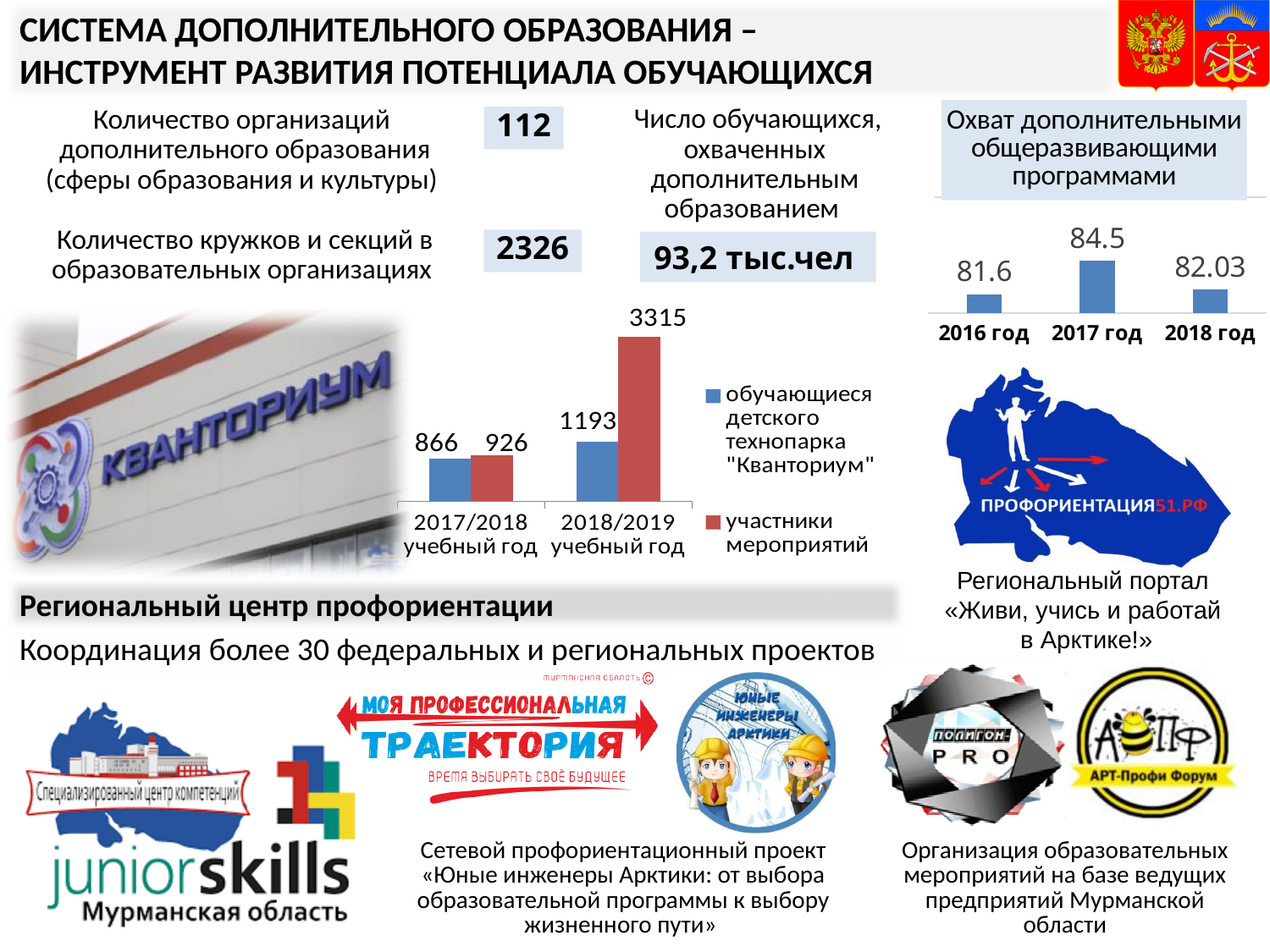
In the Кванториум bar chart in the middle of the slide, which is larger in 2017/2018 учебный год: обучающиеся детского технопарка "Кванториум" or участники мероприятий? участники мероприятий In the Кванториум bar chart in the middle of the slide, what is the value for участники мероприятий in 2018/2019 учебный год? 3315 In the chart titled «Охват дополнительными общеразвивающими программами», how many years are shown? 3 In the Кванториум bar chart in the middle of the slide, what is the difference between участники мероприятий and обучающиеся детского технопарка "Кванториум" in 2018/2019 учебный год? 2122 In the chart titled «Охват дополнительными общеразвивающими программами», which year has the lowest value? 2016 год In the Кванториум bar chart in the middle of the slide, how many series does the legend list? 2 In the chart titled «Охват дополнительными общеразвивающими программами», what is the value for 2017 год? 84.5 In the Кванториум bar chart in the middle of the slide, do the values for участники мероприятий rise or fall from 2017/2018 to 2018/2019 учебный год? rise In the chart titled «Охват дополнительными общеразвивающими программами», what is the value for 2016 год? 81.6 In the chart titled «Охват дополнительными общеразвивающими программами», which year has the highest value? 2017 год In the chart titled «Охват дополнительными общеразвивающими программами», what kind of chart is it? bar chart In the Кванториум bar chart in the middle of the slide, what is the value for обучающиеся детского технопарка "Кванториум" in 2017/2018 учебный год? 866